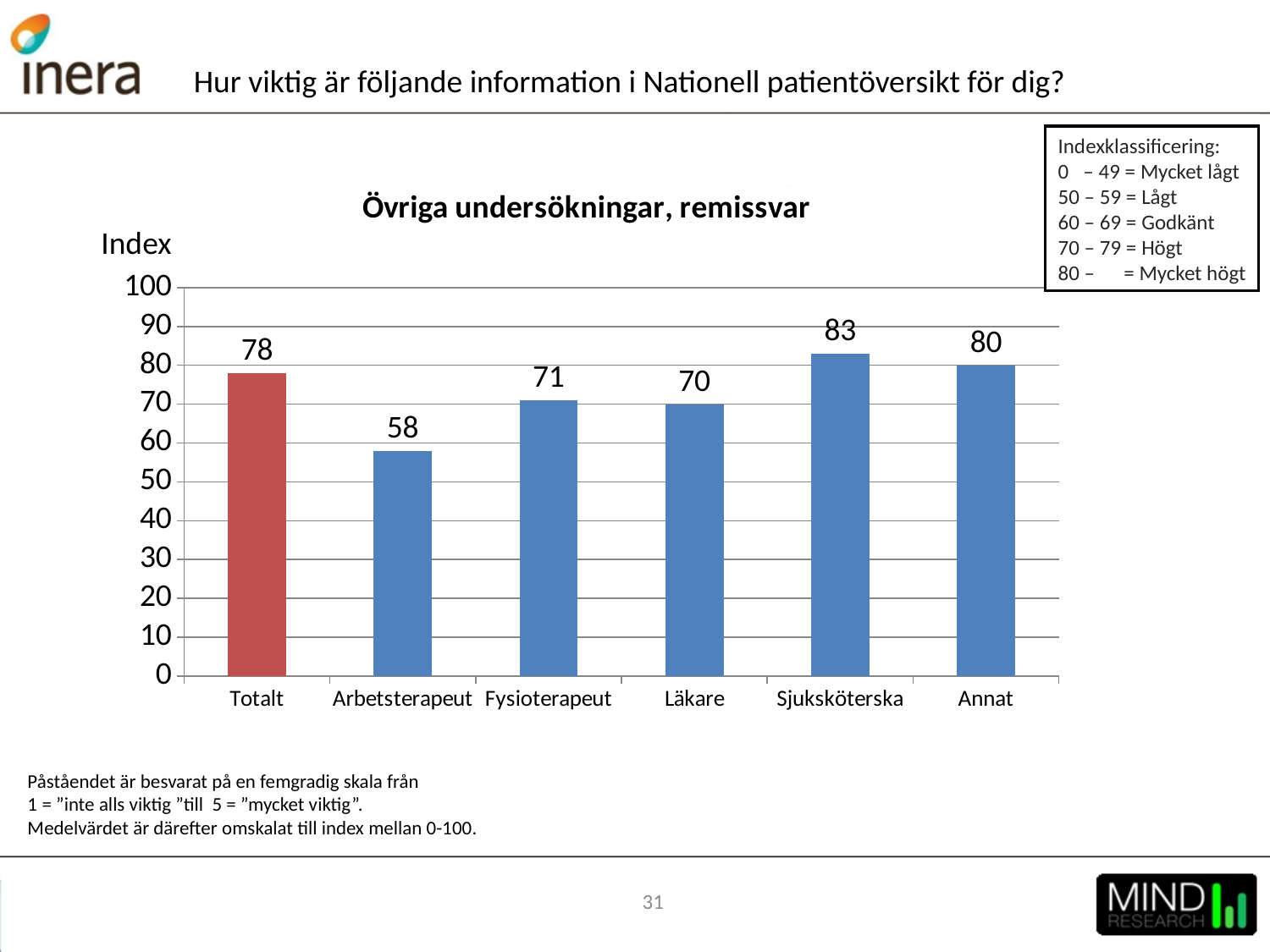
What is the index value for Totalt? 78 What is the index value for Sjuksköterska? 83 Which has a higher index value, Annat or Läkare? Annat What is the title of the chart? Övriga undersökningar, remissvar What is the index value for Arbetsterapeut? 58 Which bar is coloured differently (red) from the others? Totalt What kind of chart is shown on the slide? bar chart Which category has the highest index value? Sjuksköterska Is the value for Fysioterapeut greater or less than 60? greater Which category has the lowest index value? Arbetsterapeut What is the difference between the index values for Sjuksköterska and Arbetsterapeut? 25 How many categories are shown on the x axis? 6